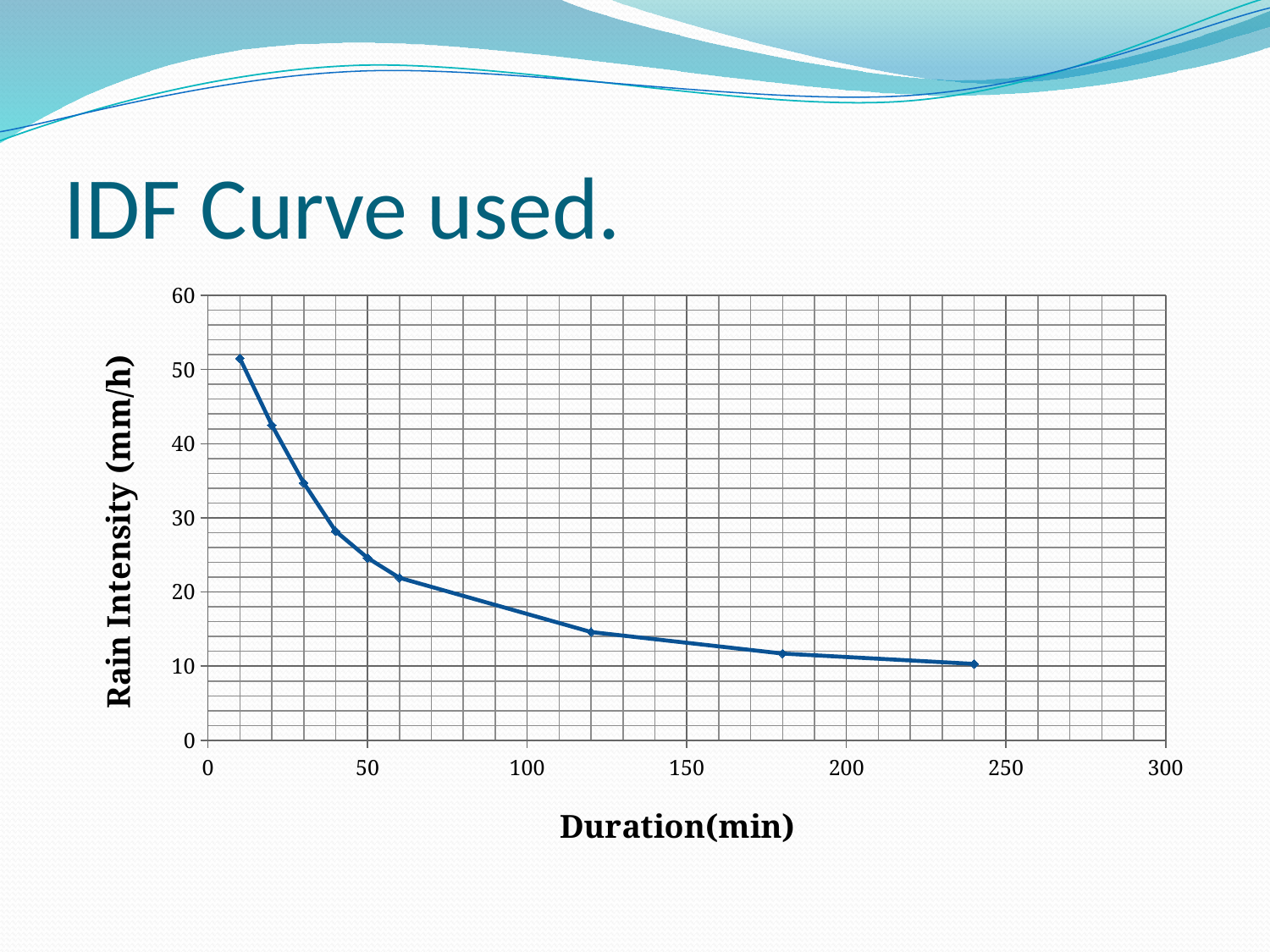
Does rain intensity rise or fall as duration increases along the x axis? fall At which duration is the rain intensity lowest? 240 min How many data points are plotted on the curve? 9 What is the label of the y axis? Rain Intensity (mm/h) What is the label of the x axis? Duration(min) At which duration is the rain intensity highest? 10 min Is the rain intensity at a duration of 10 min greater or less than 40 mm/h? greater What kind of chart is shown on the slide? line chart Which has the larger rain intensity: a duration of 10 min or a duration of 240 min? 10 min Is the rain intensity at a duration of 120 min greater or less than 20 mm/h? less Is the rain intensity at a duration of 30 min greater or less than 30 mm/h? greater